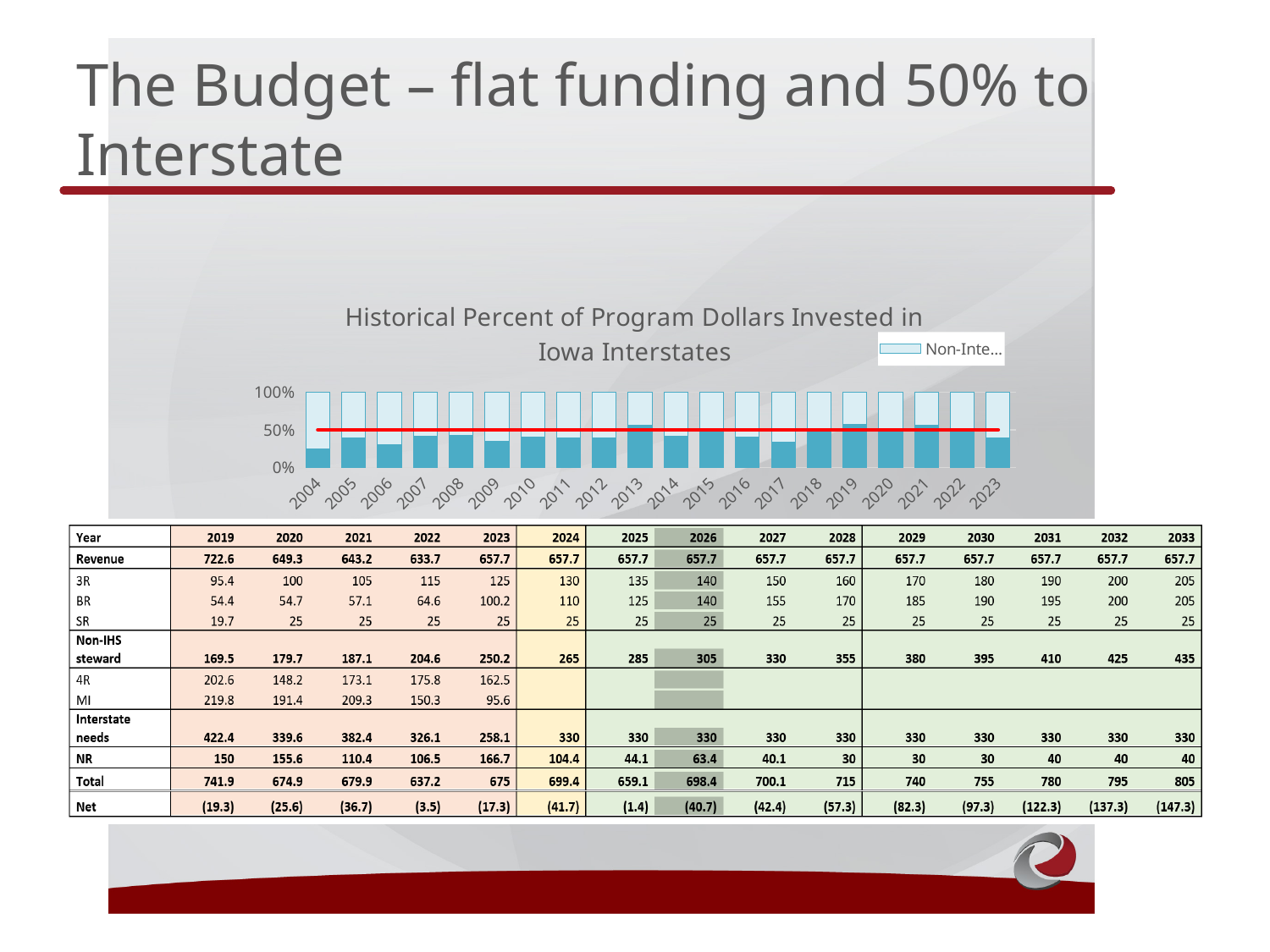
What is the last year shown on the chart's x axis? 2023 Which year has the lowest interstate share (the dark bottom segment) in the chart? 2004 Is the interstate share (dark bottom segment) for 2013 greater or less than 50%? greater What is the first year shown on the chart's x axis? 2004 Which year has the larger interstate share (dark bottom segment), 2006 or 2008? 2008 Is the interstate share (dark bottom segment) for 2017 greater or less than 50%? less What kind of chart is shown on the slide? combination bar and line chart (stacked bars with a red line) At what percentage level is the red horizontal line drawn on the chart? 50% Which year has the larger interstate share (dark bottom segment), 2004 or 2013? 2013 Is the interstate share (dark bottom segment) for 2004 greater or less than 50%? less How many years are plotted along the x axis of the chart? 20 What is the title of the chart? Historical Percent of Program Dollars Invested in Iowa Interstates